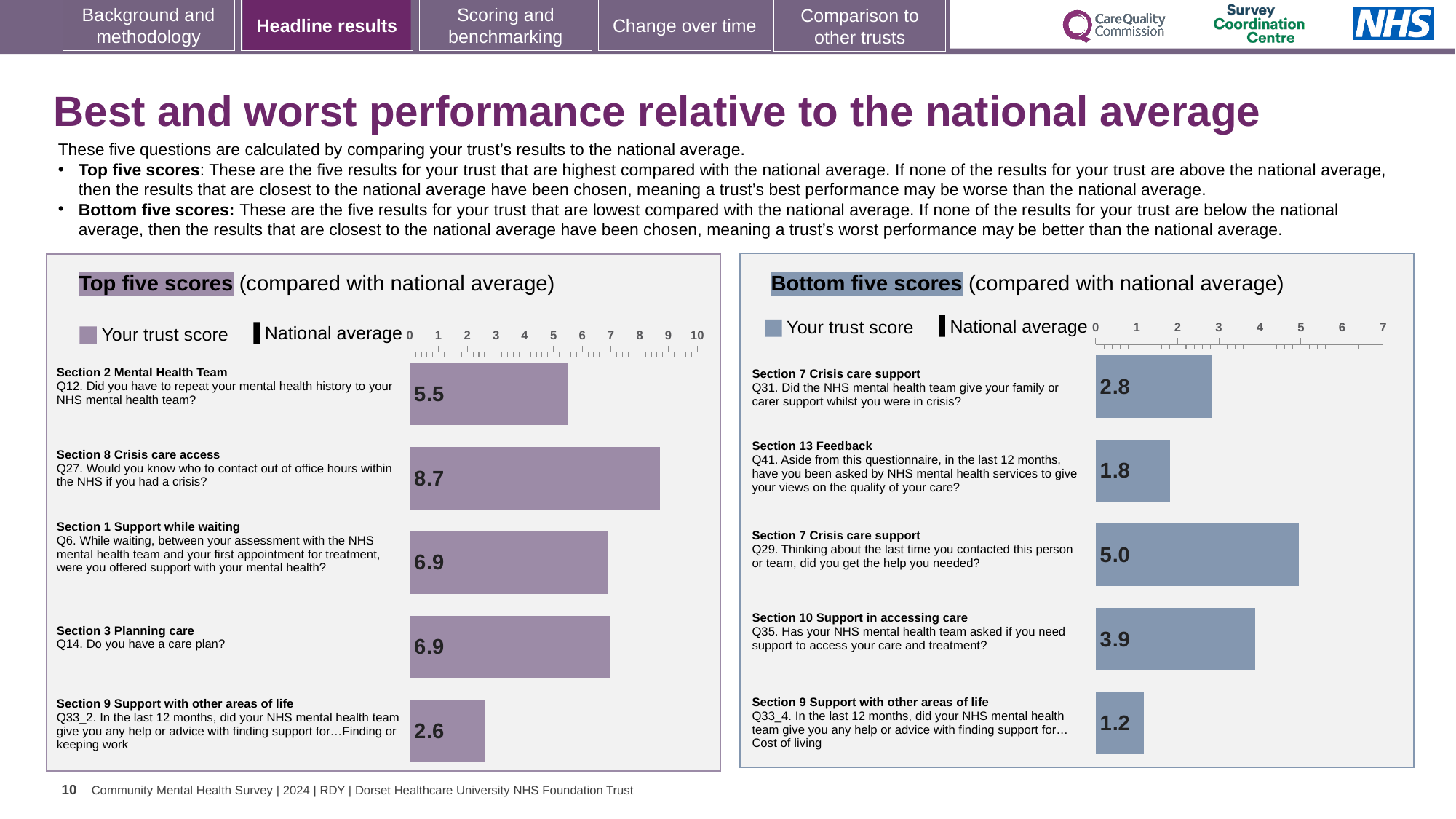
In the Top five scores chart, what is the trust score for Q12 (Did you have to repeat your mental health history to your NHS mental health team?)? 5.5 In the Bottom five scores chart, what is the trust score for Q33_4 (help or advice with finding support for cost of living)? 1.2 In the Bottom five scores chart, which is larger, the trust score for Q31 or for Q41? Q31 How many bars are plotted in the Top five scores chart? 5 In the Top five scores chart, which question has the lowest trust score? Q33_2 In the Bottom five scores chart, what is the trust score for Q29 (did you get the help you needed?)? 5.0 In the Bottom five scores chart, which question has the highest trust score? Q29 In the Bottom five scores chart, what is the difference between the trust scores for Q35 and Q41? 2.1 What type of chart is the Bottom five scores chart? Bar chart In the Top five scores chart, what is the difference between the trust scores for Q27 and Q33_2? 6.1 In the Top five scores chart, what is the trust score for Q27 (Would you know who to contact out of office hours within the NHS if you had a crisis?)? 8.7 In the Top five scores chart, which question has the highest trust score? Q27